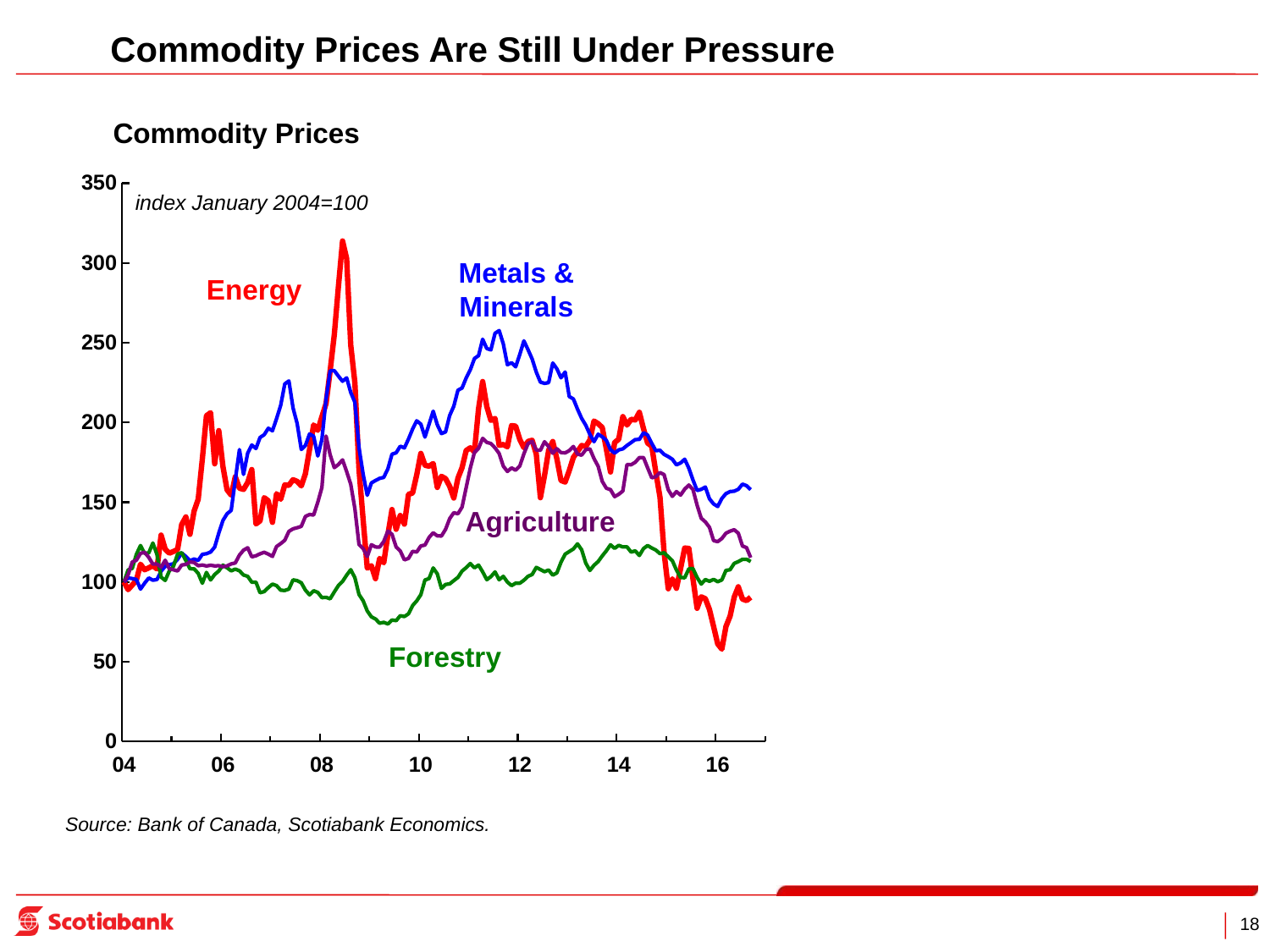
Is the peak value of the Energy series in 2008 greater or less than 300? greater Which series peaks higher: Energy or Metals & Minerals? Energy Is the peak value of the Metals & Minerals series greater or less than 200? greater Is the Energy index at the end of the period (2016) greater or less than 100? less Which series stays lowest over most of the period shown? Forestry What kind of chart is shown on the slide? line chart What is the title of the chart? Commodity Prices How many commodity price series are plotted on the chart? 4 Does the Energy series rise or fall between 2014 and 2016? fall Which series reaches the highest peak on the chart? Energy What base period is the index set to 100, according to the note on the chart? January 2004